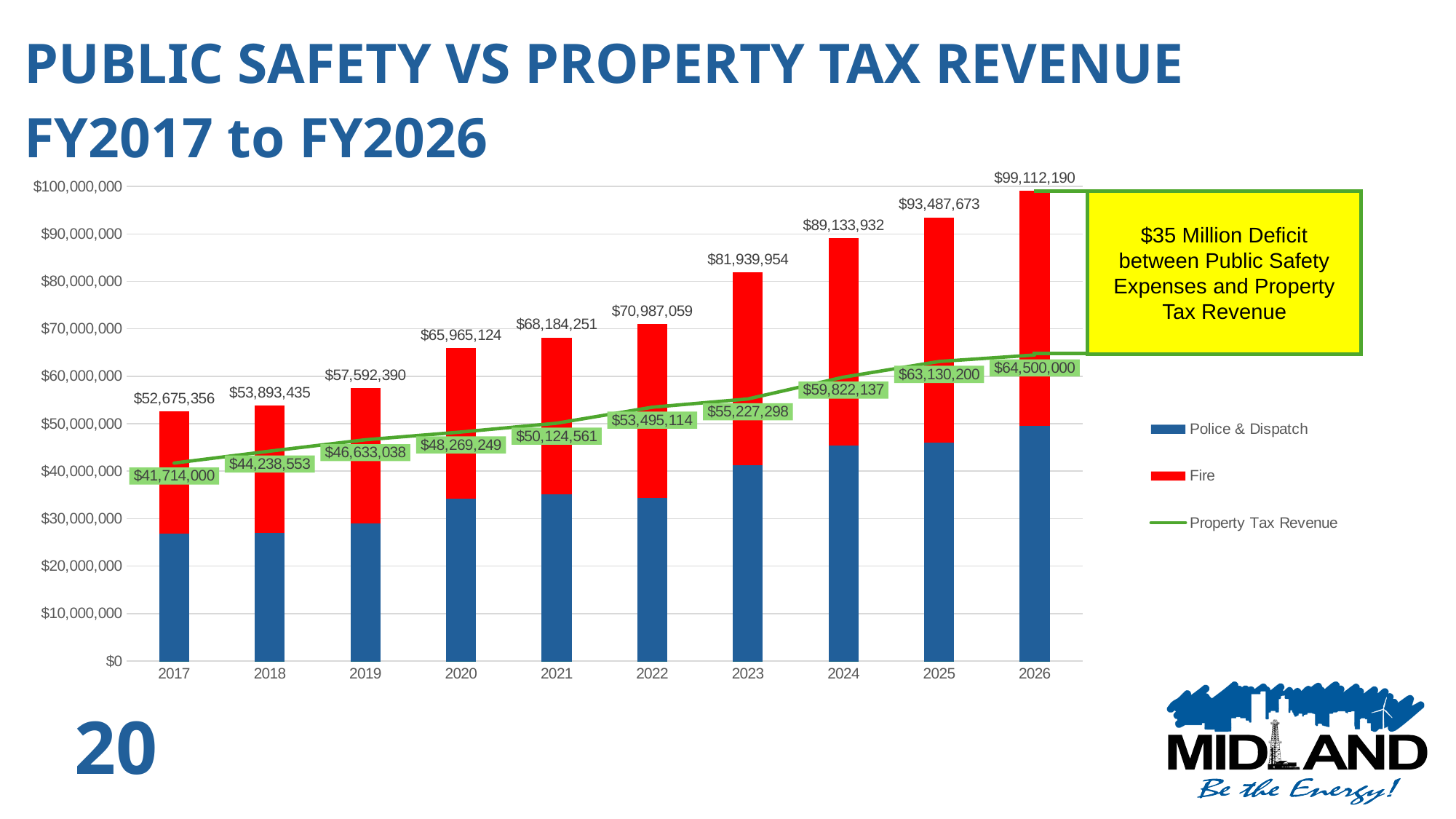
Is the Police & Dispatch value for 2017 greater or less than $30,000,000? less What is the Property Tax Revenue value labeled for 2017? $41,714,000 Does the Property Tax Revenue line rise or fall from 2017 to 2026? rise By how much did the total public safety expense grow from 2017 to 2026? $46,436,834 What is the Property Tax Revenue value labeled for 2024? $59,822,137 How many series does the legend list? 3 Which year has the lowest Property Tax Revenue? 2017 What is the total public safety expense labeled for 2026? $99,112,190 What is the total public safety expense labeled for 2023? $81,939,954 How many years are shown on the x axis? 10 What is the difference between the 2026 total public safety expense and the 2026 Property Tax Revenue? $34,612,190 Which year has the highest total public safety expense? 2026